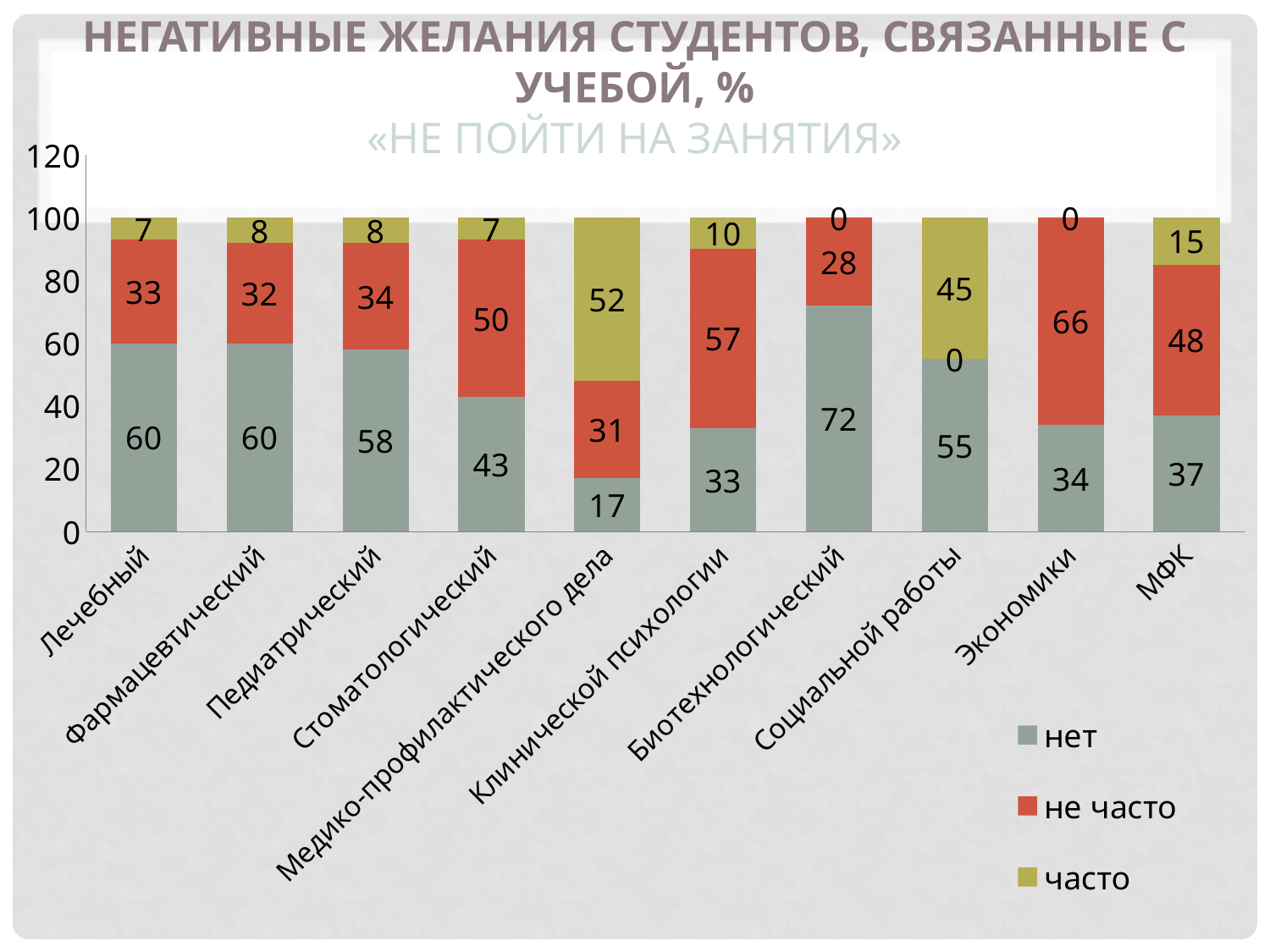
How many series does the legend list? 3 What kind of chart is shown on the slide? stacked bar chart Which is larger: the "часто" value for Социальной работы or for МФК? Социальной работы How many faculties (categories) are shown on the x axis? 10 What is the total of the stacked bar for Стоматологический? 100 What is the difference between the "не часто" values for Клинической психологии and Лечебный? 24 Which faculty has the highest value for "нет"? Биотехнологический What is the value of "нет" for Биотехнологический? 72 What is the value of "часто" for Медико-профилактического дела? 52 What is the subtitle shown in quotation marks under the chart title? «НЕ ПОЙТИ НА ЗАНЯТИЯ» What is the value of "не часто" for Экономики? 66 Which faculty has the lowest value for "нет"? Медико-профилактического дела